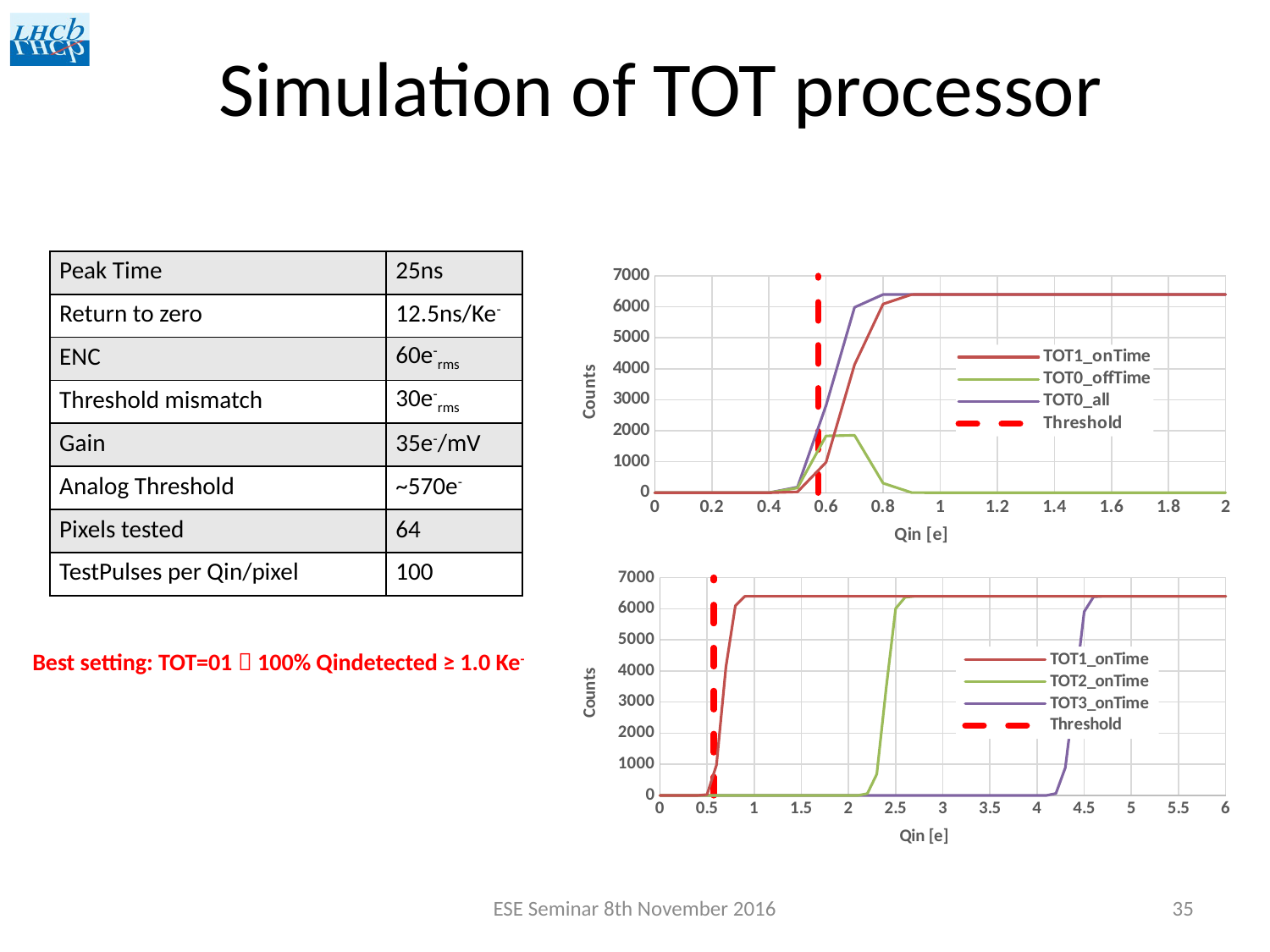
In the bottom chart, is the value of TOT2_onTime at Qin = 2 greater or less than 1000? less In the top chart, is the value of TOT1_onTime at Qin = 1 greater or less than 6000? greater In the bottom chart, which legend entry is drawn as a red dashed line? Threshold In the bottom chart, is the value of TOT3_onTime at Qin = 5 greater or less than 6000? greater In the bottom chart, does TOT1_onTime rise or fall as Qin increases from 0.5 to 1? rise In the top chart, at Qin = 1, which is larger: TOT1_onTime or TOT0_offTime? TOT1_onTime In the bottom chart, at Qin = 2, which is larger: TOT1_onTime or TOT2_onTime? TOT1_onTime How many series does the legend of the bottom chart list? 4 What kind of chart is the top chart on the right of the slide? line chart What is the label of the x axis on the bottom chart? Qin [e] How many series does the legend of the top chart list? 4